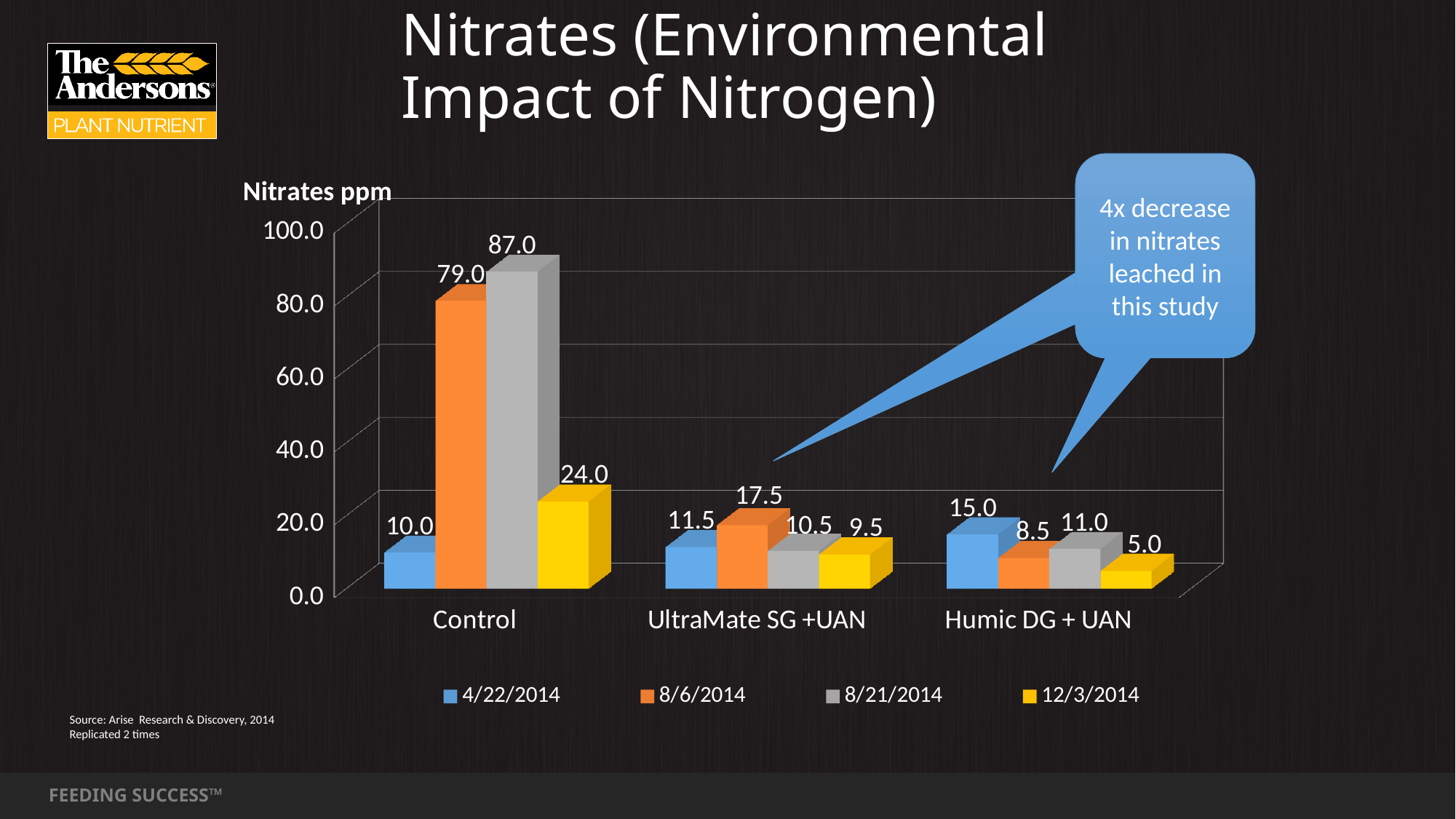
What is the difference between the Control values on 8/21/2014 and 8/6/2014? 8.0 What is the nitrates value for UltraMate SG +UAN on 8/6/2014? 17.5 What is the nitrates value for Humic DG + UAN on 12/3/2014? 5.0 Which treatment has the lowest nitrates value on 12/3/2014? Humic DG + UAN Which treatment has the highest nitrates value on 8/6/2014? Control What is the nitrates value for Control on 8/21/2014? 87.0 Which is larger: the 4/22/2014 value for Humic DG + UAN or for UltraMate SG +UAN? Humic DG + UAN How many treatment categories are shown on the x axis? 3 What kind of chart is shown on the slide? Bar chart What is the label on the vertical axis of the chart? Nitrates ppm How many series does the legend list? 4 Is the Control value on 12/3/2014 greater or less than 20.0? greater